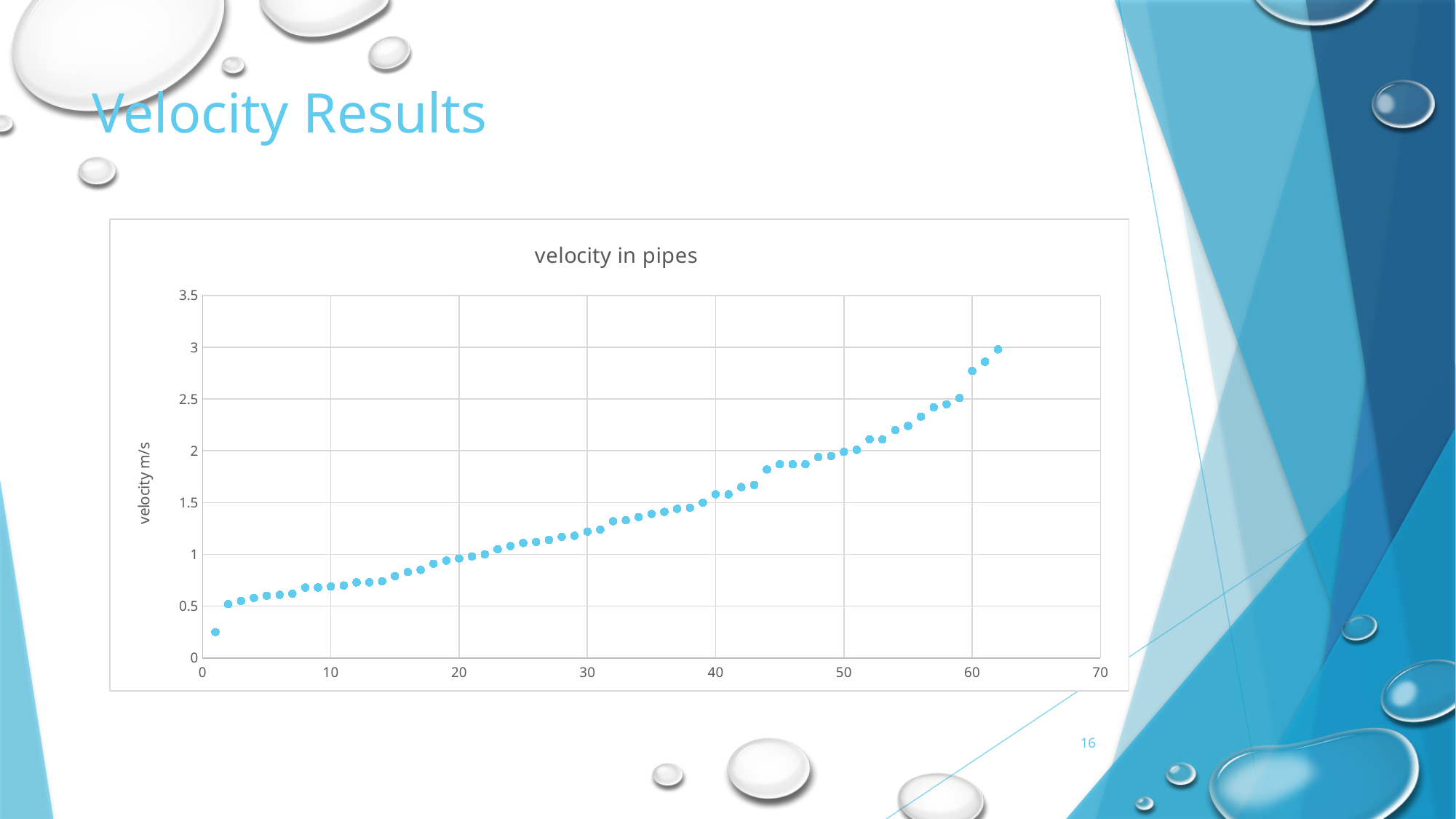
What is the maximum value shown on the vertical axis of the chart? 3.5 Is the value for the first point (x = 1) greater or less than 0.5? less Is the value for the last point (x = 62) greater or less than 2.5? greater Do the plotted velocity values rise or fall as the x value increases? rise What is the title of the chart? velocity in pipes Is the value at x = 60 greater or less than 2.5? greater What is the label on the vertical axis of the chart? velocity m/s What kind of chart is shown on the slide? scatter chart Which point has the highest velocity, the one at x = 10 or the one at x = 60? x = 60